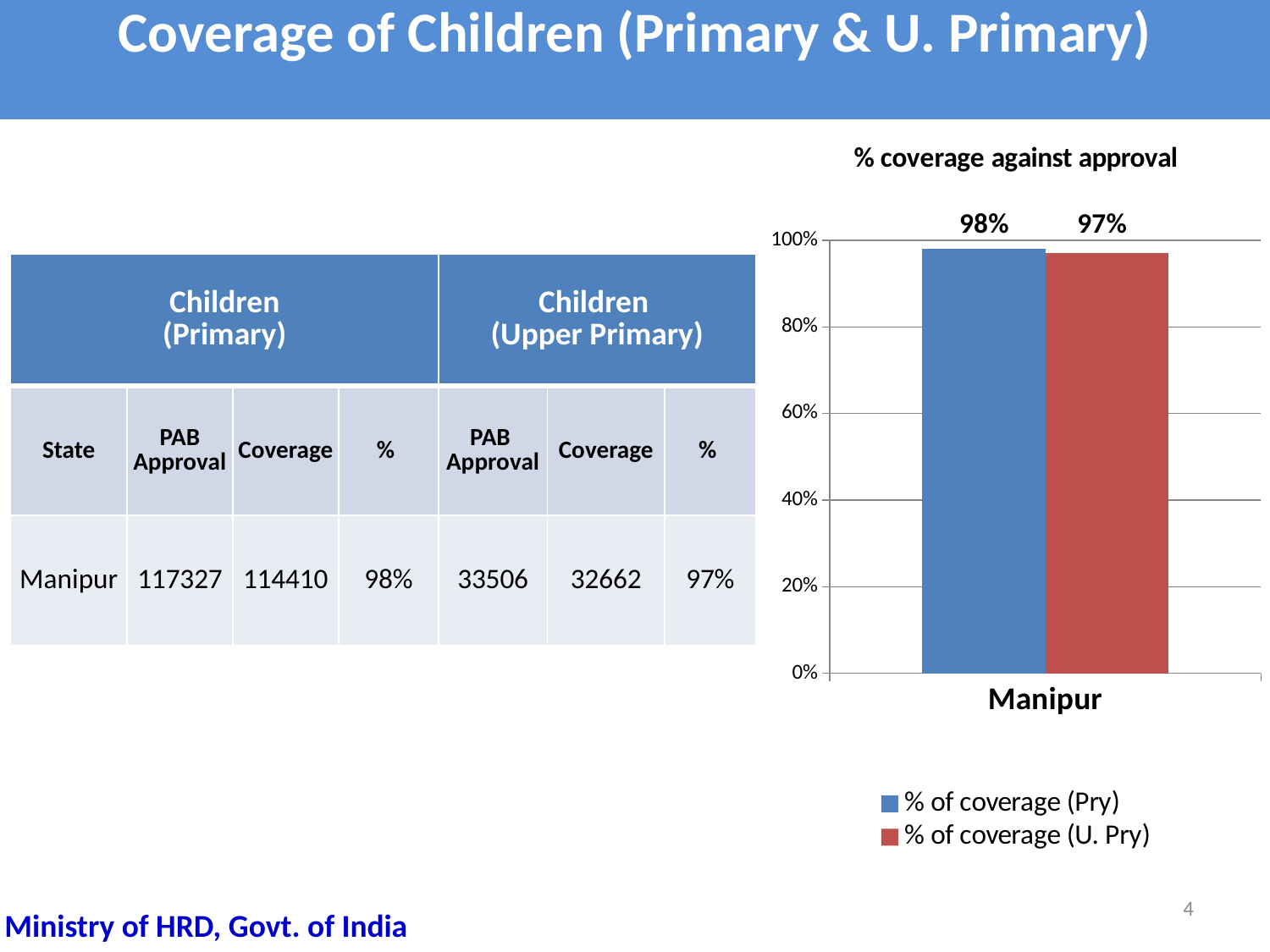
What is the title of the chart? % coverage against approval What is the value of % of coverage (Pry) for Manipur? 98% What is the difference between % of coverage (Pry) and % of coverage (U. Pry) for Manipur? 1% How many categories are shown on the x axis of the chart? 1 What kind of chart is shown on the slide? bar chart Is the value of % of coverage (U. Pry) for Manipur greater or less than 80%? greater How many series does the chart legend list? 2 Which series has the higher value for Manipur, % of coverage (Pry) or % of coverage (U. Pry)? % of coverage (Pry) What is the value of % of coverage (U. Pry) for Manipur? 97% What is the highest value shown on the chart's y axis? 100% Which colour represents % of coverage (U. Pry) in the chart? red